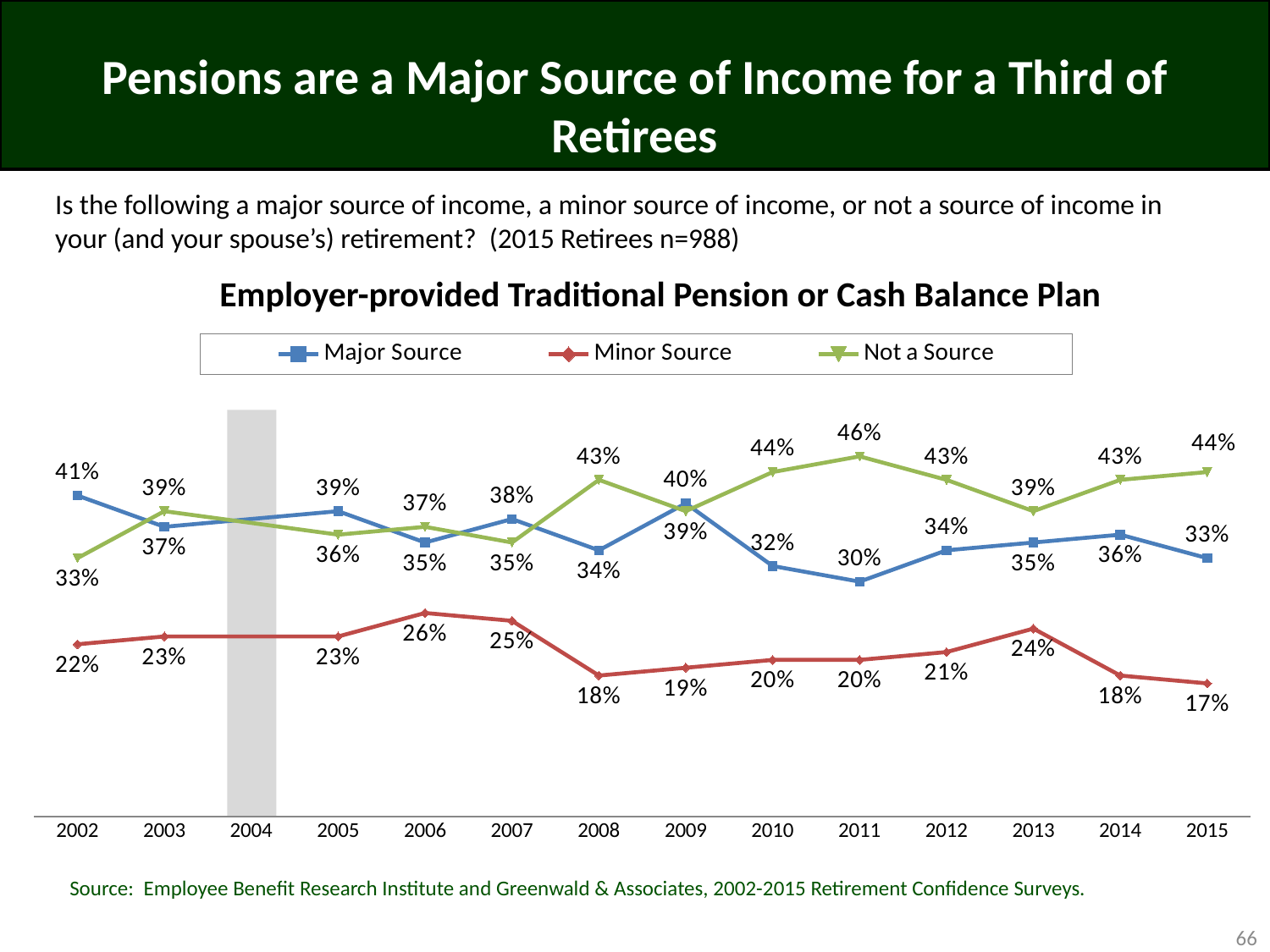
What is the value for Not a Source in 2011? 46% In which year is the Not a Source value highest? 2011 What is the value for Minor Source in 2015? 17% How many years are labelled on the x axis? 14 In 2015, what is the difference between the Not a Source value and the Major Source value? 11 percentage points In 2002, which is larger: Major Source or Not a Source? Major Source In which year is the Minor Source value lowest? 2015 Does the Minor Source value rise or fall from 2013 to 2015? Fall What kind of chart is shown on the slide? Line chart What is the value for Major Source in 2011? 30% How many series does the legend list? 3 What is the value for Major Source in 2002? 41%